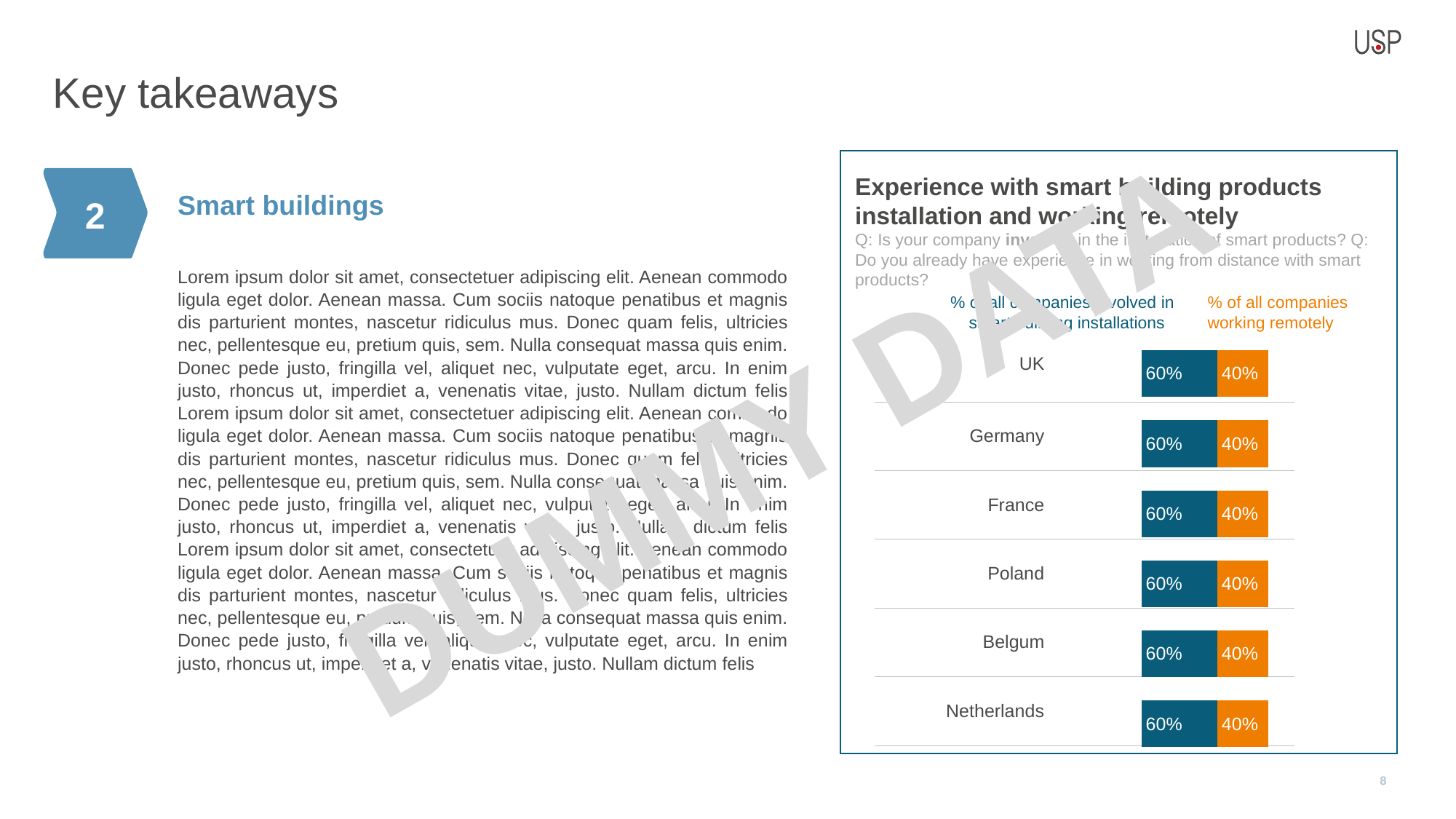
What is the value of the blue segment for Germany? 60% What kind of chart is shown on the slide? Stacked bar chart For Poland, which is larger: the blue segment or the orange segment? The blue segment (60%) Which country is listed last (at the bottom) in the chart? Netherlands What is the total of the two segments in the bar for the UK? 100% How many series does the chart show? 2 What is the value of the first (blue) segment for France? 60% What percentage of companies in the UK are working remotely according to the chart? 40% What does the orange series represent according to the legend? % of all companies working remotely What is the difference between the blue and orange values for Belgum? 20 percentage points How many countries are shown in the chart? 6 What percentage of companies in the Netherlands are working remotely? 40%